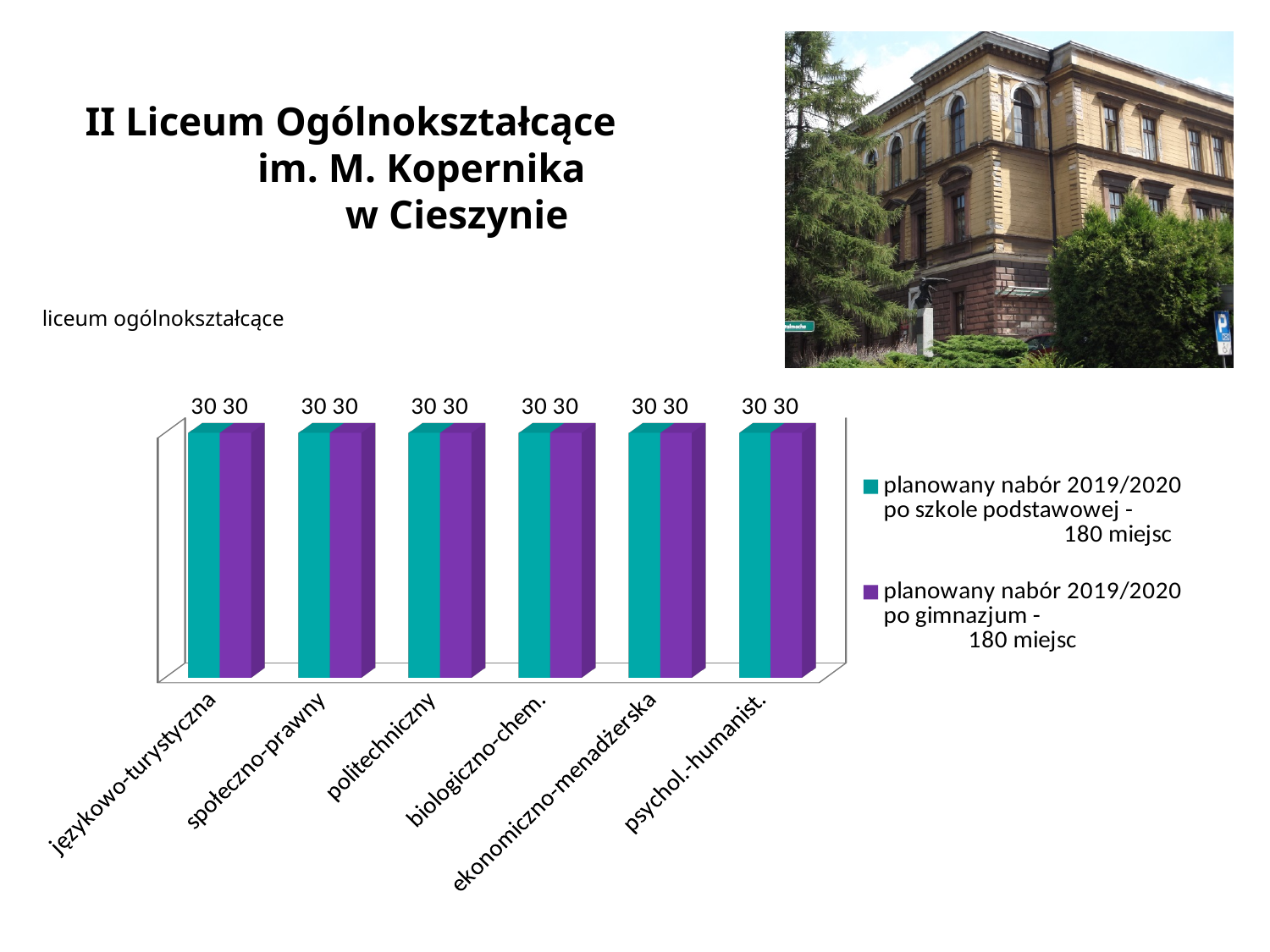
How many profiles (categories) are shown on the x axis of the chart? 6 How many series does the chart legend list? 2 Do the values for the 'po szkole podstawowej' series rise, fall, or stay flat across the profiles on the x axis? stay flat According to the legend, how many places in total are planned for the intake after primary school in 2019/2020? 180 miejsc Which colour represents the 'planowany nabór 2019/2020 po gimnazjum' series? purple What is the planned intake after primary school (po szkole podstawowej) for the językowo-turystyczna profile? 30 What value is shown for the ekonomiczno-menadżerska profile in the 'po szkole podstawowej' series? 30 What value is shown for the psychol.-humanist. profile in the 'po gimnazjum' series? 30 What kind of chart is shown on the slide? bar chart What is the planned intake after gimnazjum for the politechniczny profile? 30 What is the difference between the 'po szkole podstawowej' and 'po gimnazjum' values for the biologiczno-chem. profile? 0